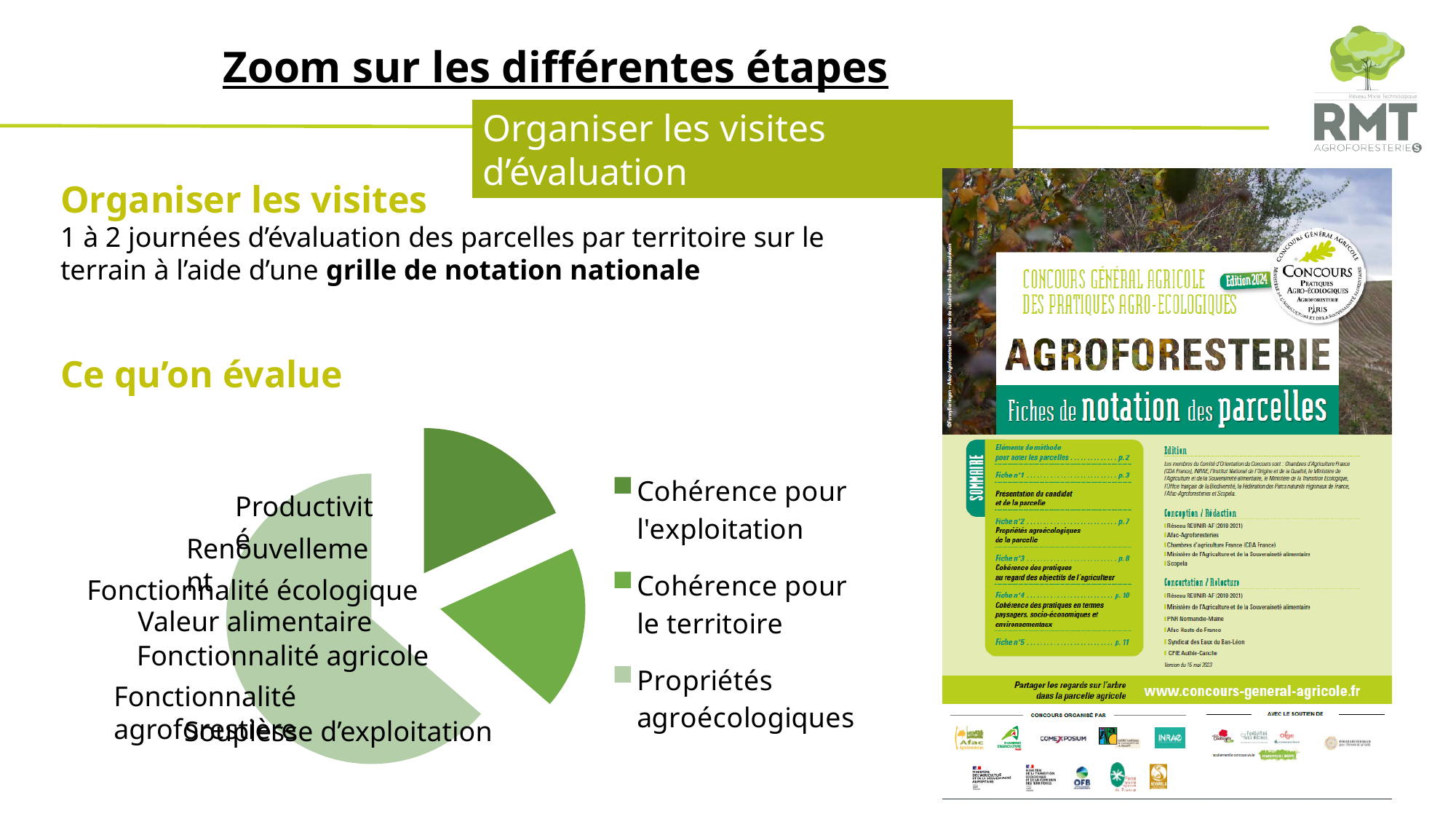
What kind of chart is shown on the slide under "Ce qu'on évalue"? pie chart Which legend category has the largest slice in the pie chart? Propriétés agroécologiques How many entries does the legend of the pie chart list? 3 What colour is the "Propriétés agroécologiques" slice in the pie chart? light green Which slice is larger in the pie chart: "Propriétés agroécologiques" or "Cohérence pour l'exploitation"? Propriétés agroécologiques How many slices does the pie chart have? 3 Which slice is larger in the pie chart: "Propriétés agroécologiques" or "Cohérence pour le territoire"? Propriétés agroécologiques Which legend entry is shown in the darkest green in the pie chart? Cohérence pour l'exploitation